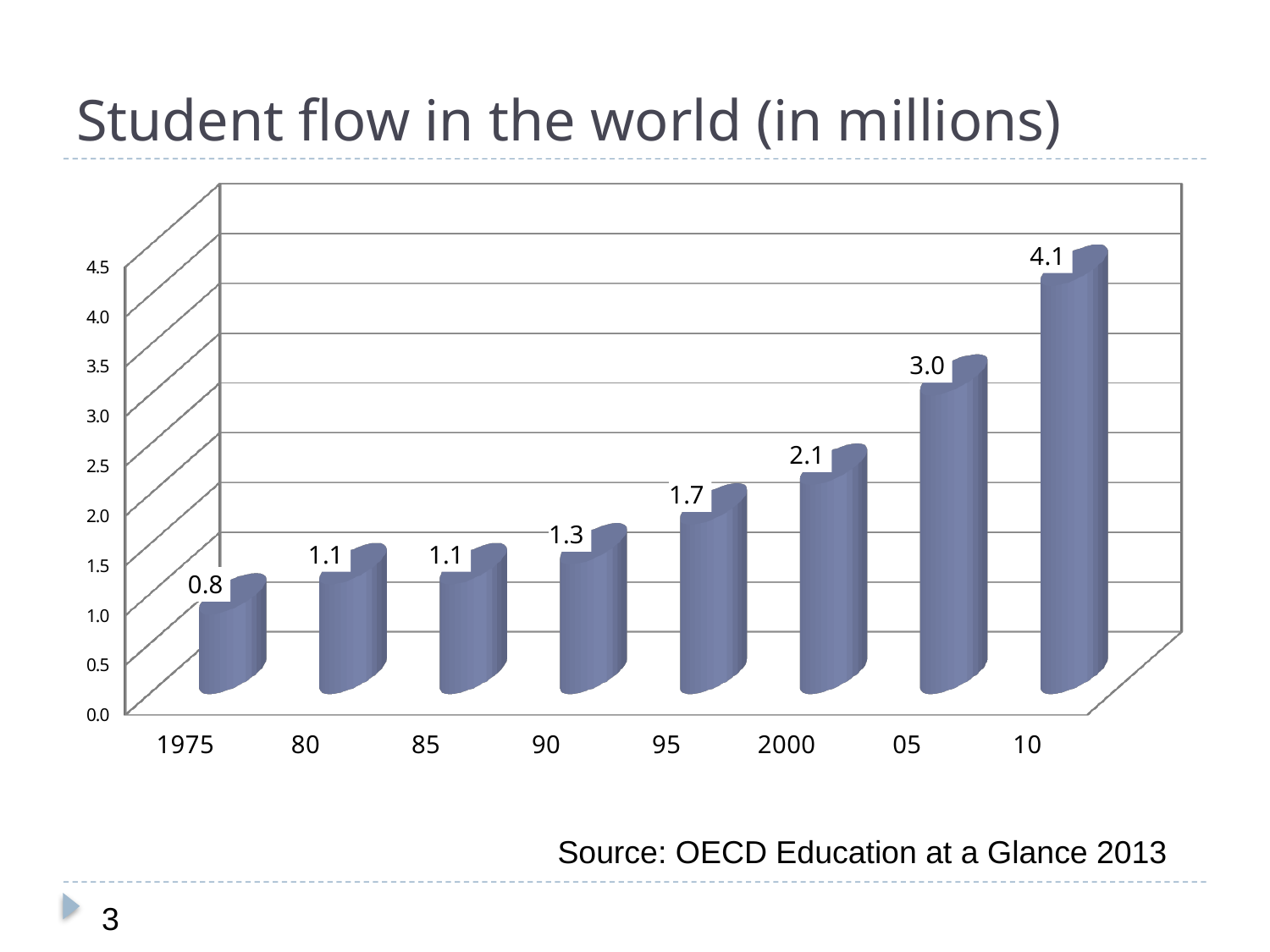
Which year has the highest value? 10 What is the difference between the values for 10 and 05? 1.1 What is the value for 2000? 2.1 Do the values rise or fall from 1975 to 10? rise What is the value for 05? 3.0 What kind of chart is shown on the slide? bar chart What is the value for 1975? 0.8 Which year has the lowest value? 1975 How many bars are shown in the chart? 8 What is the title of the chart? Student flow in the world (in millions) What is the difference between the values for 2000 and 95? 0.4 Which is larger, the value for 90 or the value for 95? 95